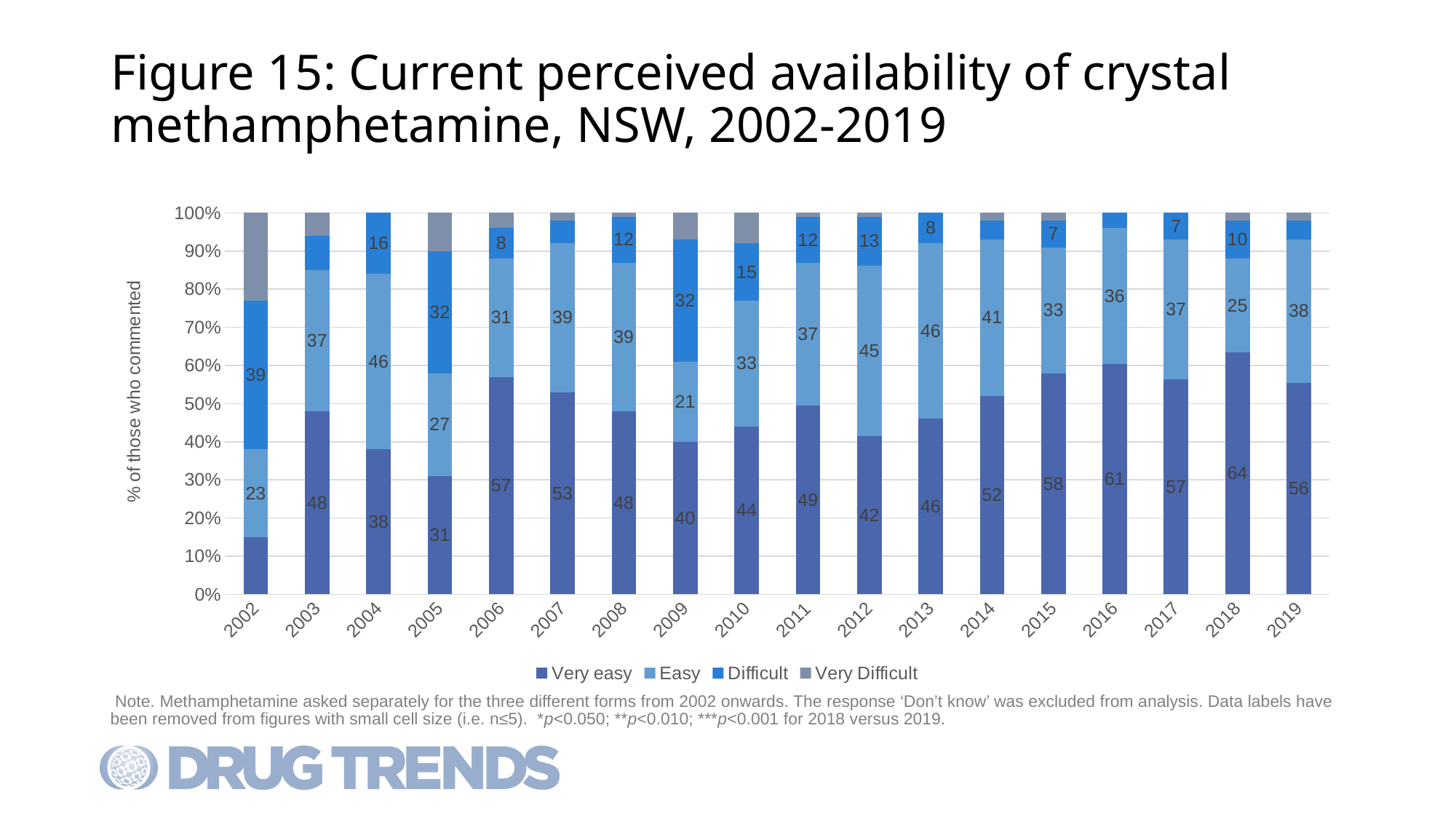
What kind of chart is shown? stacked bar chart What is the Easy value for 2009? 21 Which year has the highest Difficult value? 2002 What is the Very easy value for 2018? 64 How many years are shown on the x axis? 18 Which year has the highest Very easy value? 2018 What is the difference between the Very easy values for 2018 and 2019? 8 What is the Difficult value for 2002? 39 How many series does the legend list? 4 Does the Very easy value rise or fall from 2014 to 2018? rise Is the Very easy value for 2002 greater or less than 20%? less Which is larger, the Very easy value for 2006 or for 2007? 2006